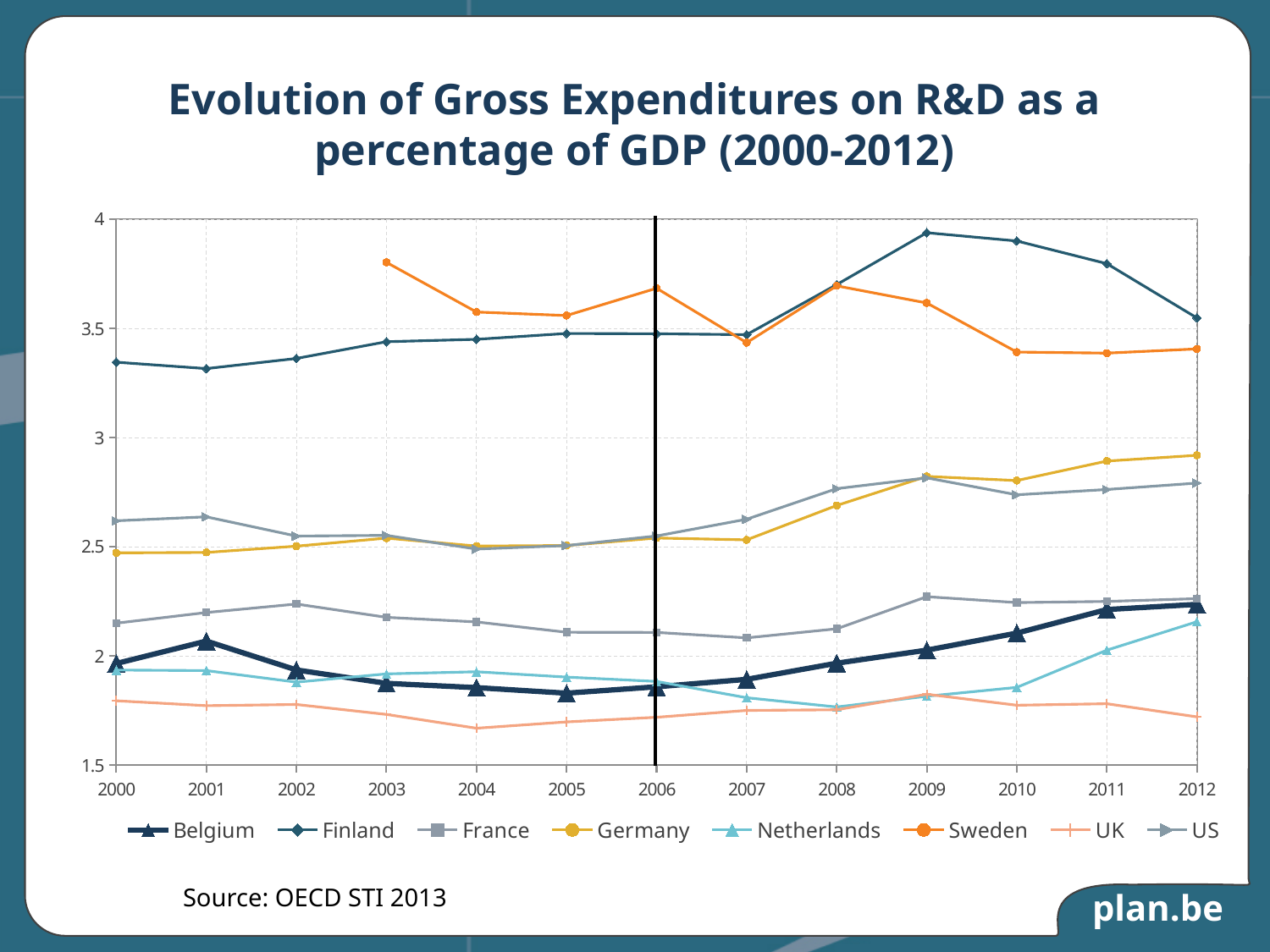
Is the value for Sweden in 2003 greater or less than 3.5? greater Which country has the lowest value in 2012? UK In 2008, which is higher: Belgium or Netherlands? Belgium In 2012, which is higher: Germany or US? Germany Does the Belgium line rise or fall from 2005 to 2012? rise How many years are plotted along the x axis? 13 Is the value for Finland in 2009 greater or less than 3.5? greater Is the value for Belgium in 2005 greater or less than 2? less What type of chart is shown on the slide? line chart Which year does the vertical black line on the chart mark? 2006 Which country has the highest R&D expenditure as a percentage of GDP in 2009? Finland How many series does the legend list? 8